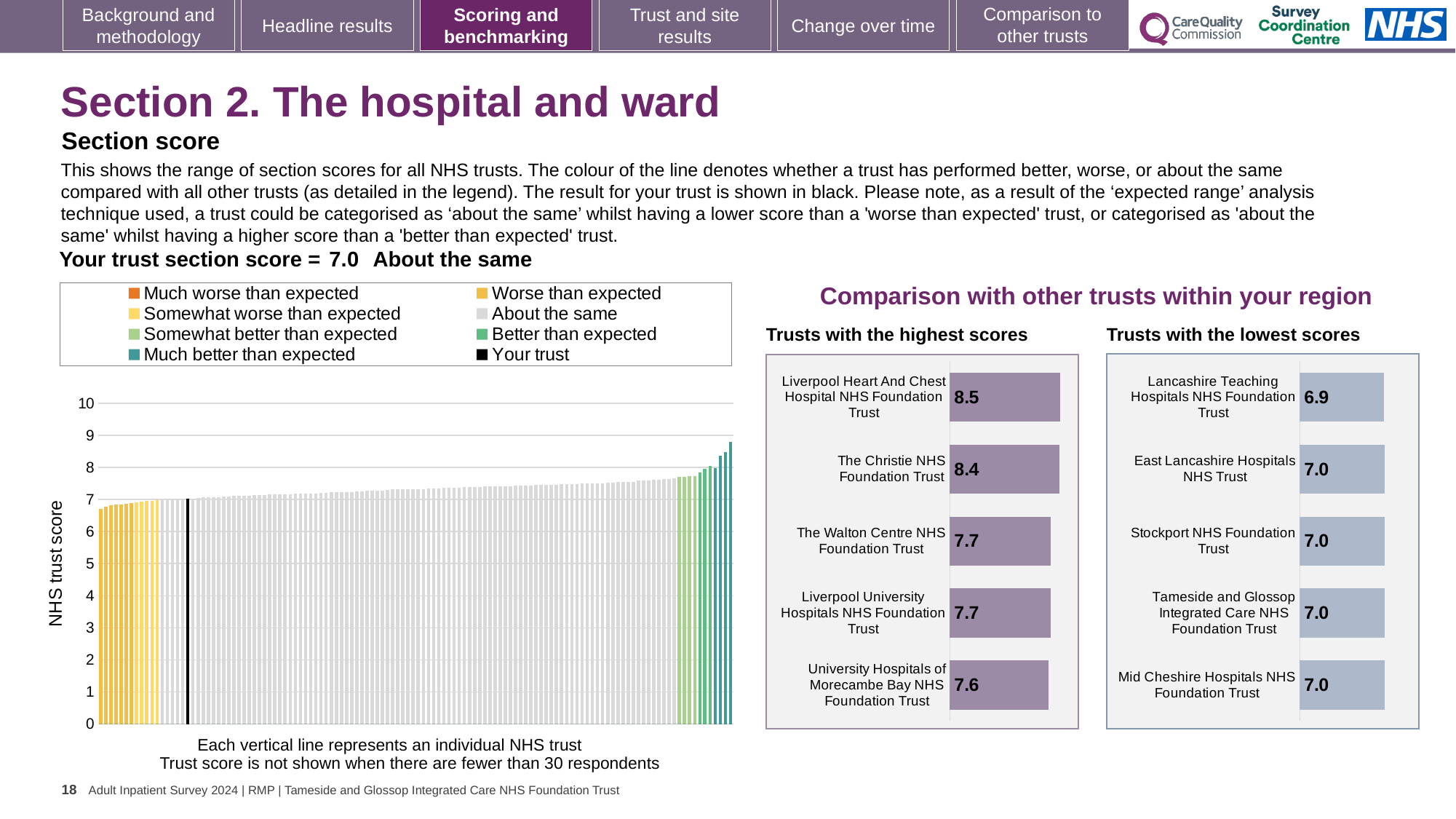
In the 'Trusts with the highest scores' chart, how many trusts are listed? 5 In the 'Trusts with the highest scores' chart, which is larger: the score for The Christie NHS Foundation Trust or the score for University Hospitals of Morecambe Bay NHS Foundation Trust? The Christie NHS Foundation Trust In the 'Trusts with the highest scores' chart, what is the difference between the scores of The Christie NHS Foundation Trust and The Walton Centre NHS Foundation Trust? 0.7 In the 'Trusts with the lowest scores' chart, what is the score for Lancashire Teaching Hospitals NHS Foundation Trust? 6.9 What kind of chart is the large chart on the left showing NHS trust scores? Bar chart How many entries does the legend of the large chart on the left list? 8 In the 'Trusts with the highest scores' chart, what is the score for Liverpool Heart And Chest Hospital NHS Foundation Trust? 8.5 In the 'Trusts with the lowest scores' chart, which trust has the lowest score? Lancashire Teaching Hospitals NHS Foundation Trust In the large chart on the left, do the trust scores rise or fall from left to right? Rise In the 'Trusts with the lowest scores' chart, what is the score for Tameside and Glossop Integrated Care NHS Foundation Trust? 7.0 In the 'Trusts with the highest scores' chart, which trust has the highest score? Liverpool Heart And Chest Hospital NHS Foundation Trust In the 'Trusts with the highest scores' chart, what is the score for University Hospitals of Morecambe Bay NHS Foundation Trust? 7.6